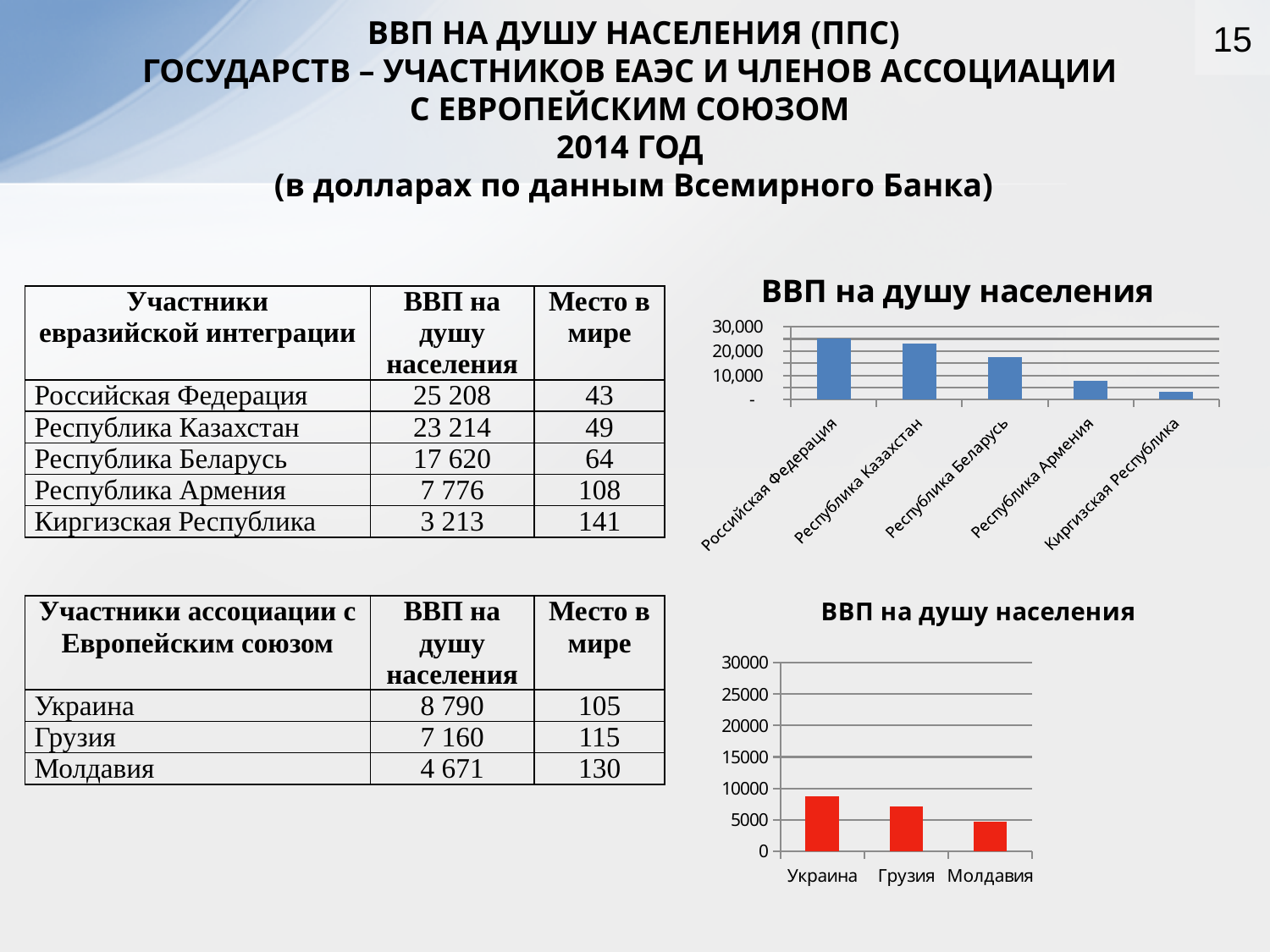
In the top-right chart (blue bars), is the value for Республика Армения greater or less than 10,000? less In the bottom-right chart (red bars), do the values rise or fall from left to right along the x axis? fall How many countries are shown in the bottom-right chart (red bars)? 3 What is the title of the bottom-right chart? ВВП на душу населения In the bottom-right chart (red bars), is the value for Молдавия greater or less than 5000? less What type of chart is the top-right chart on the slide? bar chart In the bottom-right chart (red bars), which country has the highest value? Украина In the top-right chart (blue bars), is the value for Республика Беларусь greater or less than 20,000? less In the top-right chart (blue bars), which country has the lowest GDP per capita? Киргизская Республика How many countries are shown in the top-right chart (blue bars)? 5 In the top-right chart (blue bars), which country has the highest GDP per capita? Российская Федерация In the bottom-right chart (red bars), which country has the lowest value? Молдавия